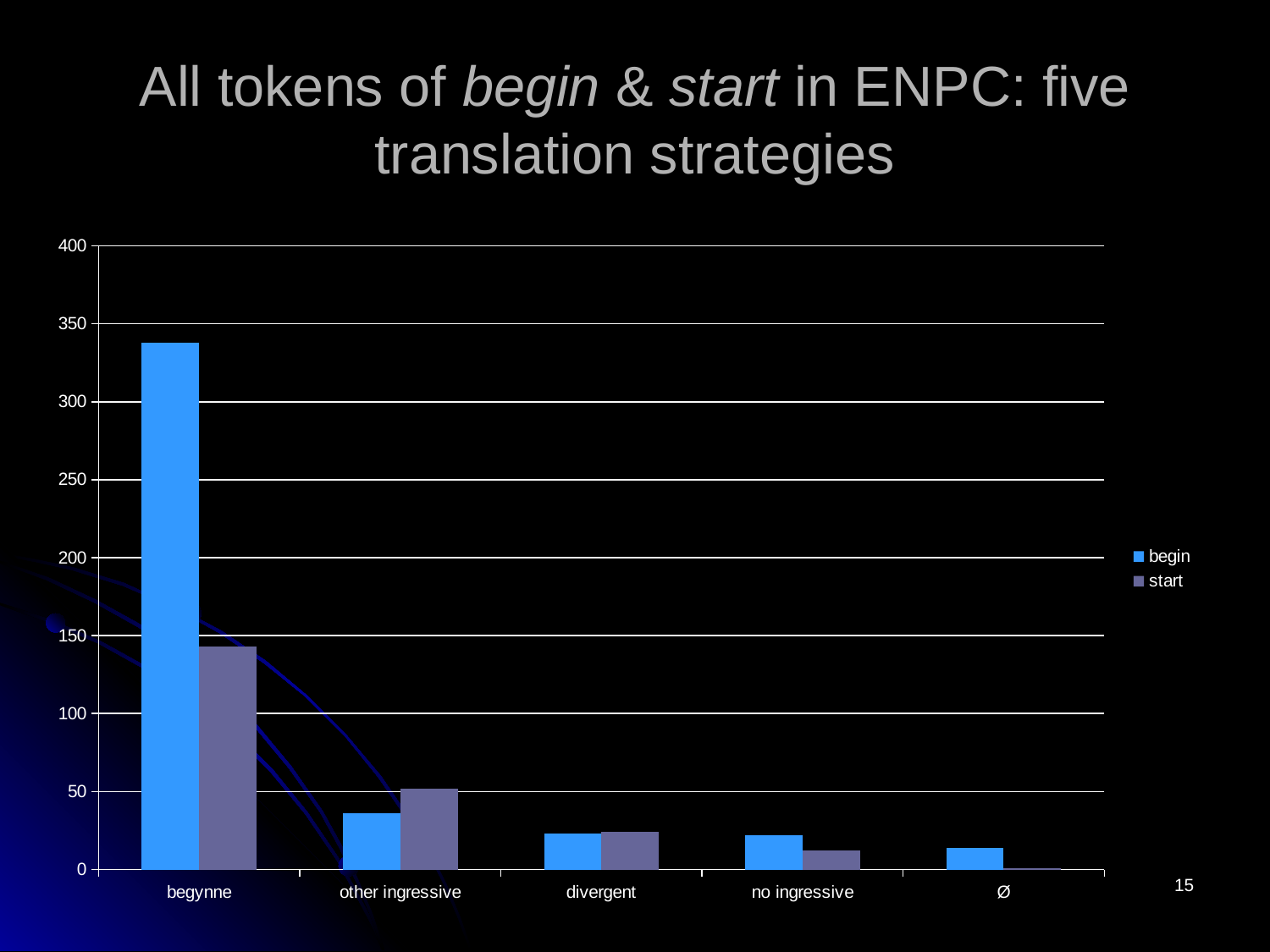
Which category has the highest value for the start series? begynne In the no ingressive category, which series has the larger value, begin or start? begin Is the value for begin in the begynne category greater or less than 300? greater What kind of chart is shown on the slide? bar chart Is the value for start in the begynne category greater or less than 150? less How many series does the legend list? 2 In the other ingressive category, which series has the larger value, begin or start? start Which category has the highest value for the begin series? begynne Which category has the lowest value for the begin series? Ø How many translation strategy categories are shown on the x axis? 5 Do the values for the begin series rise or fall moving from left to right along the x axis? fall